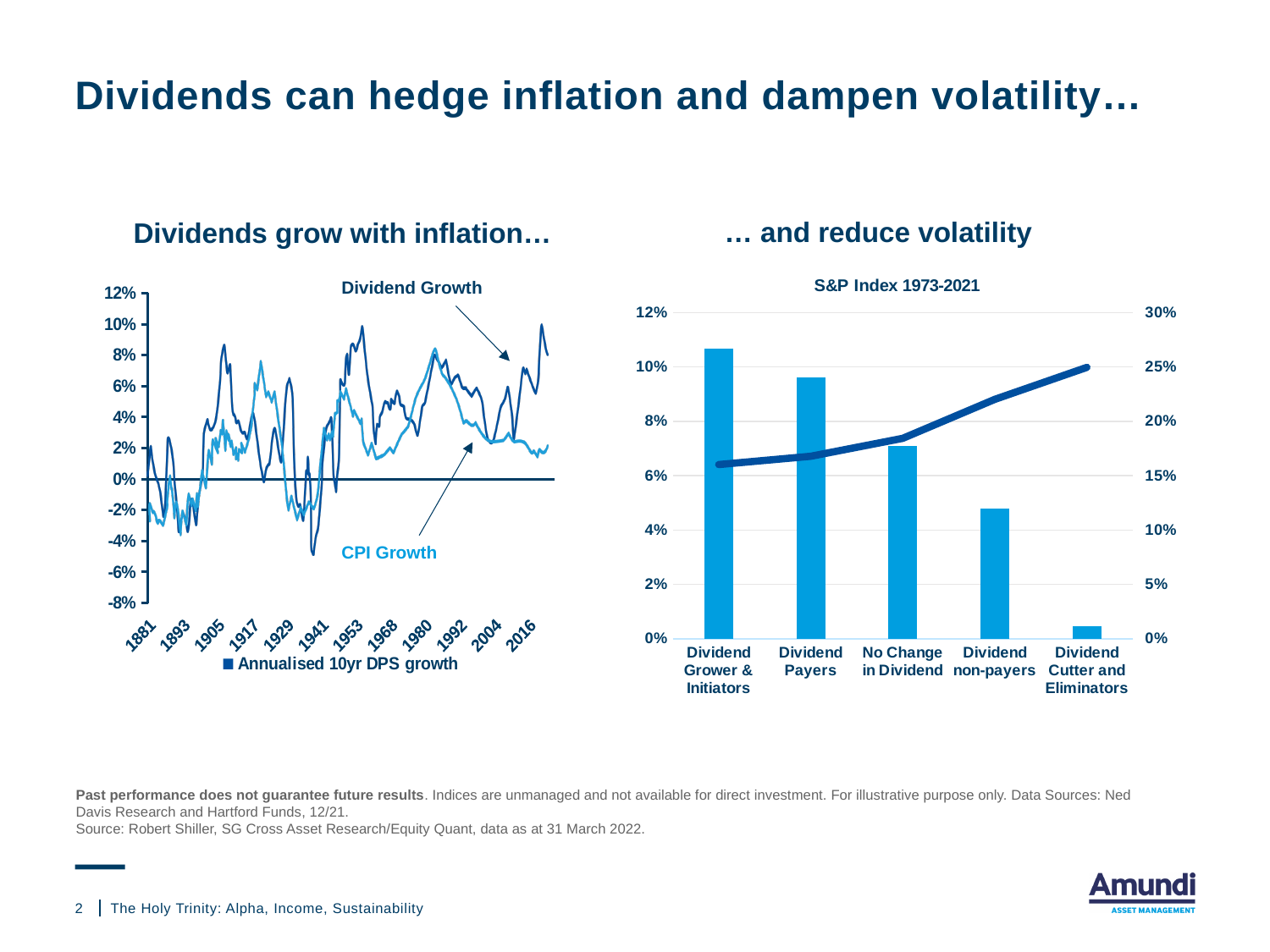
In the right-hand chart titled 'S&P Index 1973-2021', which bar is taller: No Change in Dividend or Dividend non-payers? No Change in Dividend In the right-hand chart titled 'S&P Index 1973-2021', what is the highest tick value shown on the right-hand axis? 30% In the left-hand chart titled 'Dividends grow with inflation…', what are the two labelled lines called? Dividend Growth and CPI Growth In the right-hand chart titled 'S&P Index 1973-2021', is the bar for Dividend non-payers greater or less than 6%? less In the right-hand chart titled 'S&P Index 1973-2021', is the bar for Dividend Payers greater or less than 8%? greater In the right-hand chart titled 'S&P Index 1973-2021', does the line plotted against the right-hand axis rise or fall from left to right? rise In the left-hand chart titled 'Dividends grow with inflation…', what is the first year label on the x axis? 1881 In the right-hand chart titled 'S&P Index 1973-2021', how many categories are shown on the x axis? 5 What kind of chart is the left-hand chart titled 'Dividends grow with inflation…'? line chart In the right-hand chart titled 'S&P Index 1973-2021', do the bars rise or fall from left to right across the categories? fall In the right-hand chart titled 'S&P Index 1973-2021', which category has the shortest bar? Dividend Cutter and Eliminators In the right-hand chart titled 'S&P Index 1973-2021', which category has the tallest bar? Dividend Grower & Initiators